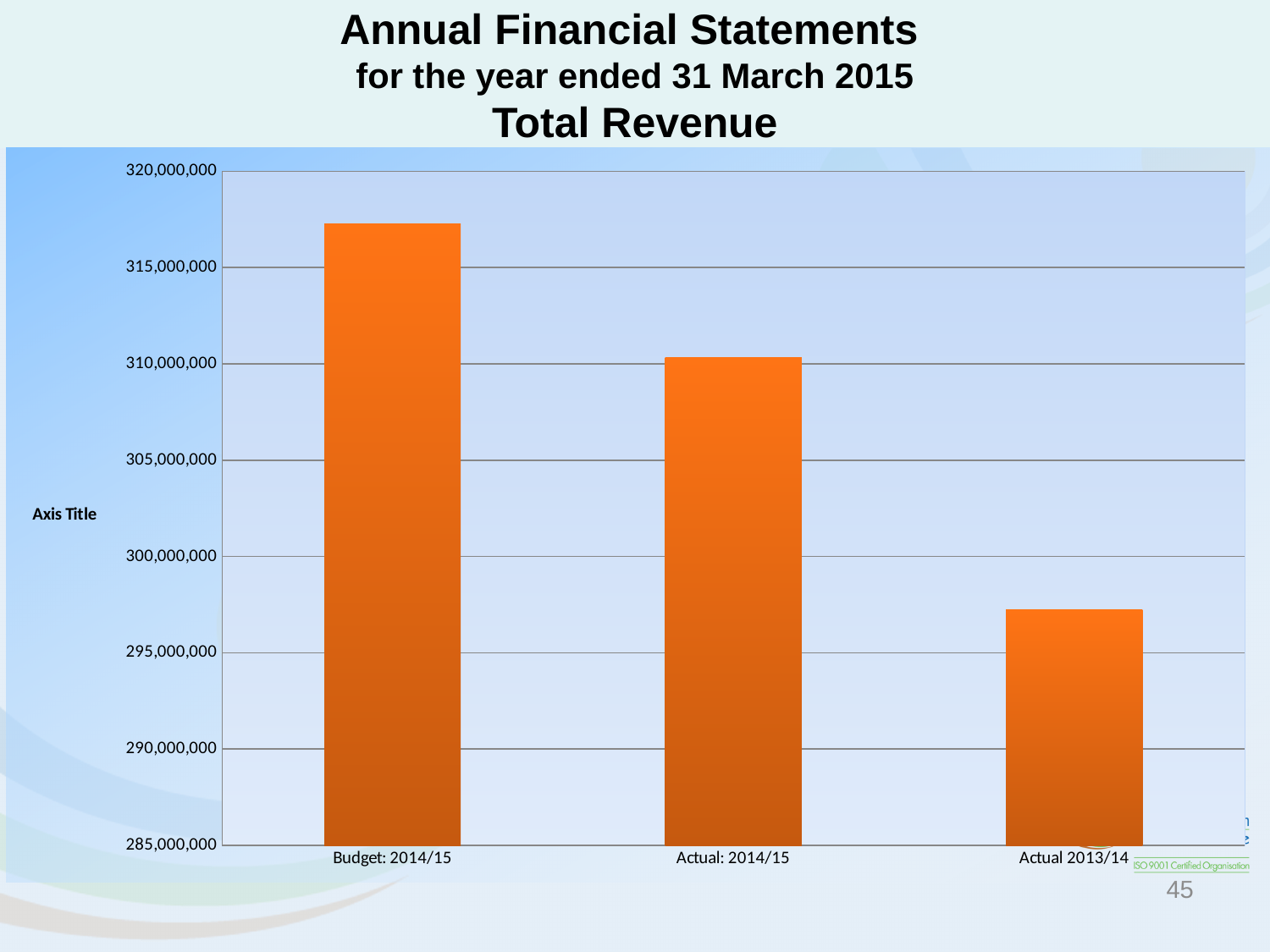
Do the bar values rise or fall from left to right across the categories? fall What is the title of the chart on the slide? Total Revenue Which is larger, the value for Actual: 2014/15 or the value for Actual 2013/14? Actual: 2014/15 Is the value for Actual: 2014/15 greater or less than 310,000,000? greater Is the value for Actual 2013/14 greater or less than 300,000,000? less How many bars are plotted in the chart? 3 Is the value for Actual 2013/14 greater or less than 295,000,000? greater Which is larger, the value for Budget: 2014/15 or the value for Actual: 2014/15? Budget: 2014/15 Which category has the highest value? Budget: 2014/15 What kind of chart is shown on the slide? bar chart Which category has the lowest value? Actual 2013/14